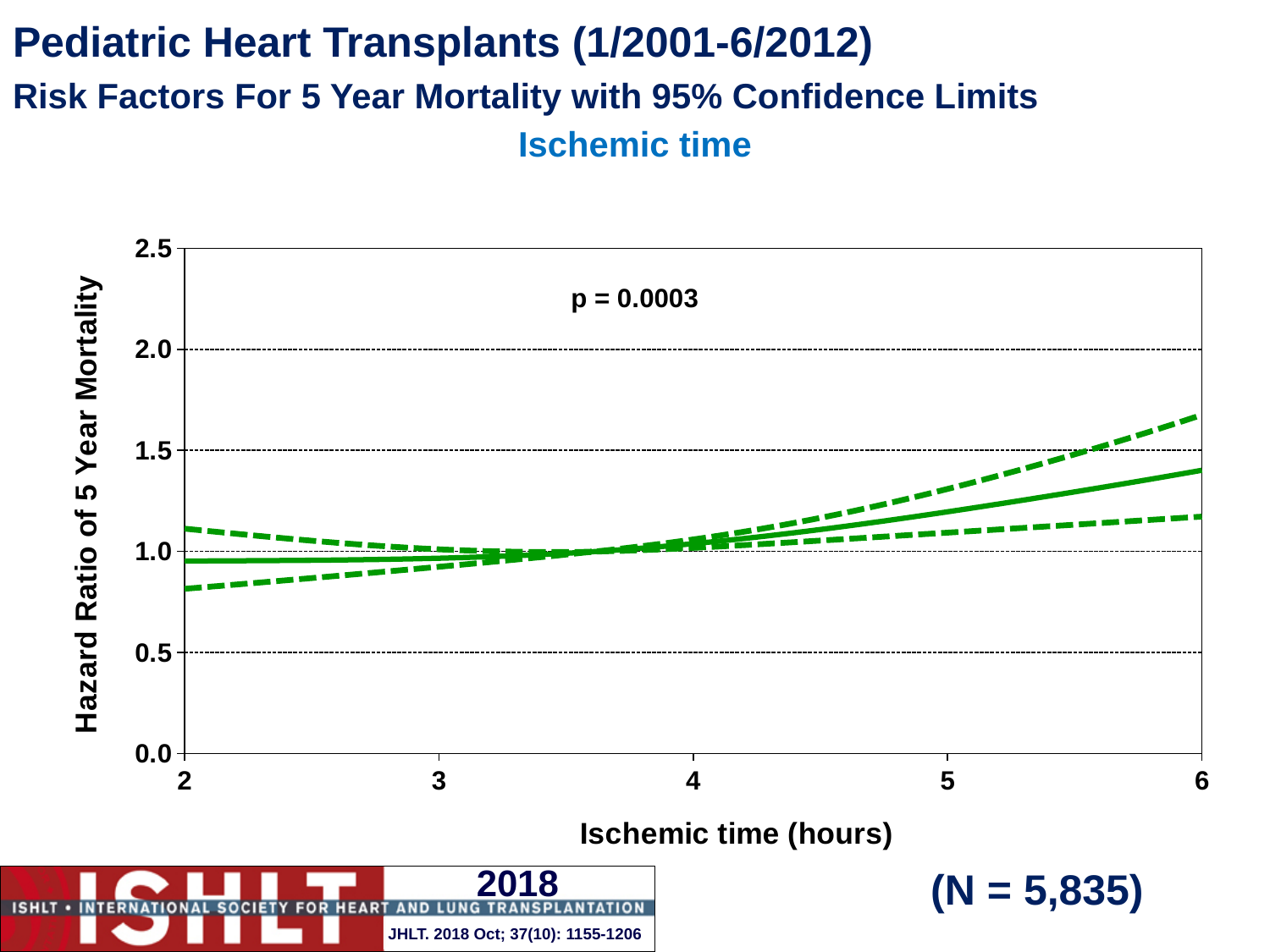
Is the solid hazard ratio line at 6 hours greater or less than 1.5? less Does the solid hazard ratio line rise or fall as ischemic time increases from 2 to 6 hours? rises Is the solid hazard ratio line higher at 2 hours or at 6 hours of ischemic time? 6 hours Is the upper dashed confidence limit at 6 hours greater or less than 1.5? greater Is the lower dashed confidence limit at 2 hours greater or less than 1.0? less What sample size (N) is shown on the slide? N = 5,835 How many lines are plotted on the chart? 3 What p-value is printed on the chart? p = 0.0003 What kind of chart is shown on the slide? line chart